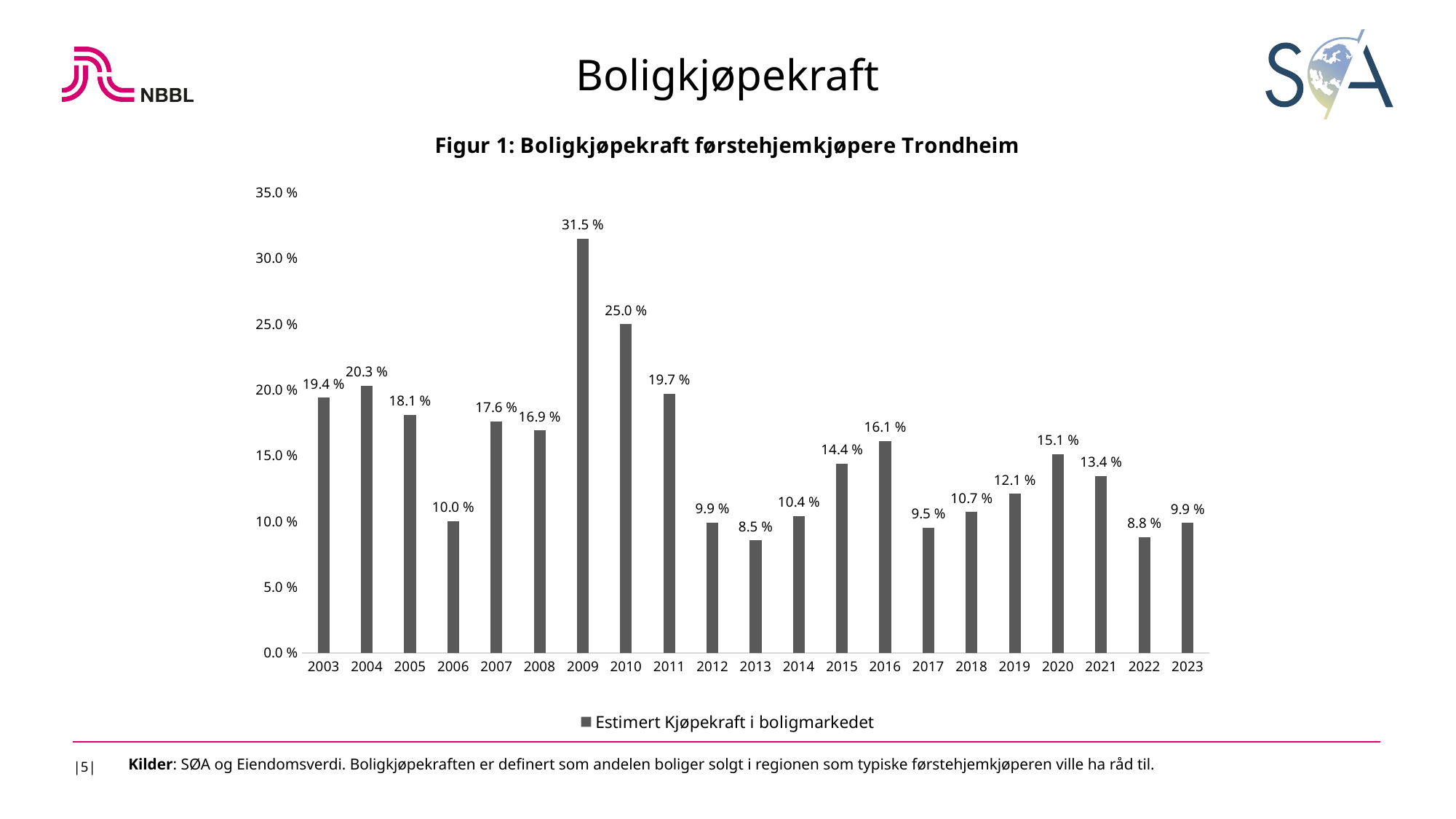
Which is larger, the value for 2004 or the value for 2003? 2004 Which year has the lowest value? 2013 How many series does the legend list? 1 What kind of chart is shown? bar chart How many years are shown on the x axis? 21 What is the difference between the values for 2020 and 2022? 6.3 % What is the value for 2009? 31.5 % What is the value for 2023? 9.9 % What is the value for 2016? 16.1 % What is the difference between the values for 2009 and 2010? 6.5 % Is the value for 2010 greater or less than 20.0 %? greater Which year has the highest value? 2009